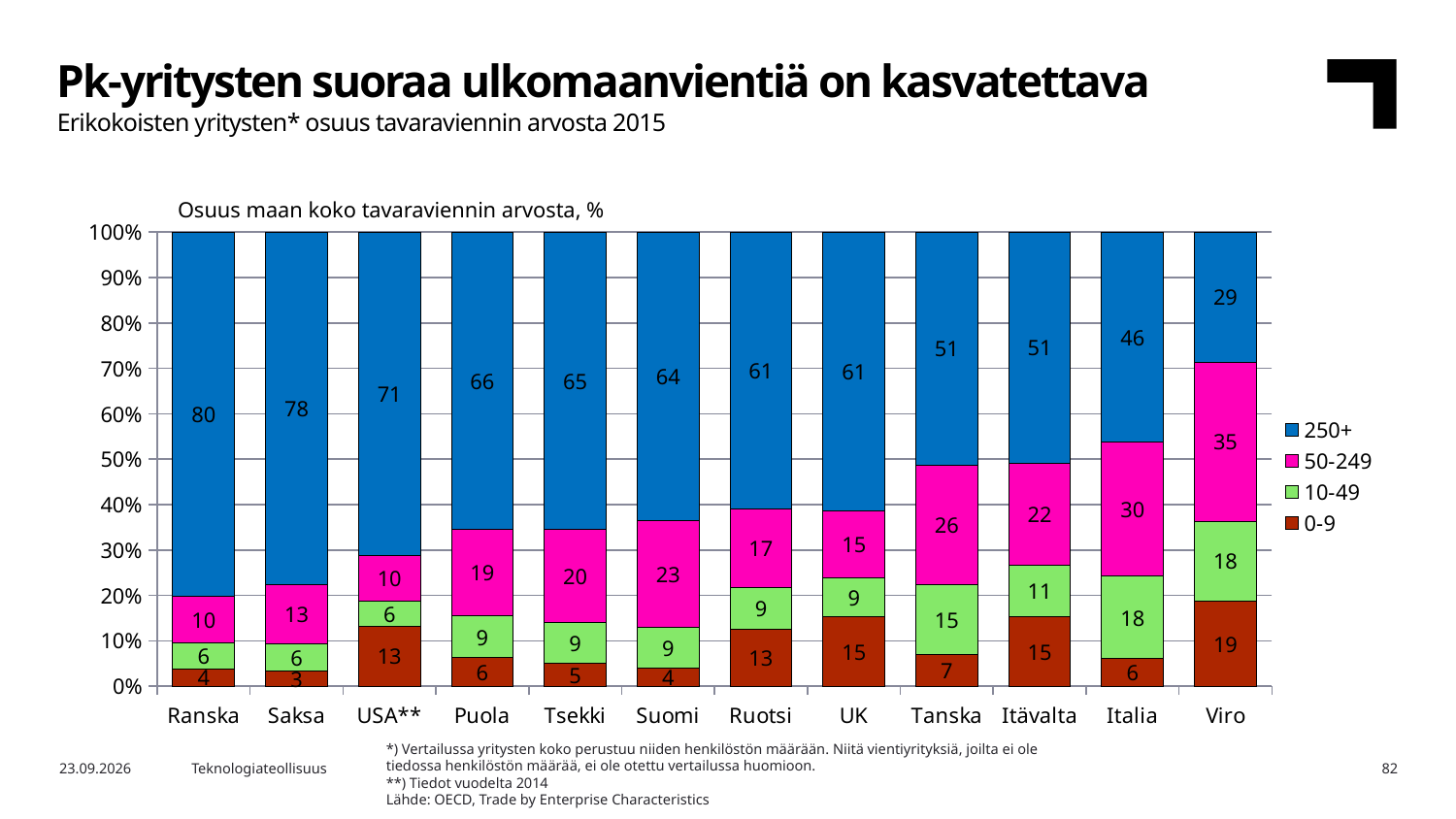
Which country has the highest value for the 250+ series? Ranska How many series does the legend list? 4 What kind of chart is shown on the slide? Stacked bar chart Which country has the lowest value for the 250+ series? Viro What is the title of the chart's axis label above the plot area? Osuus maan koko tavaraviennin arvosta, % Which country has the highest value for the 50-249 series? Viro What is the value for the 0-9 series for Viro? 19 Which is larger: the 0-9 value for USA** or the 0-9 value for Puola? USA** What is the difference between the 250+ values for Ranska and Viro? 51 How many countries are shown on the x axis? 12 What is the value for the 250+ series for Ranska? 80 What is the value for the 50-249 series for Suomi? 23